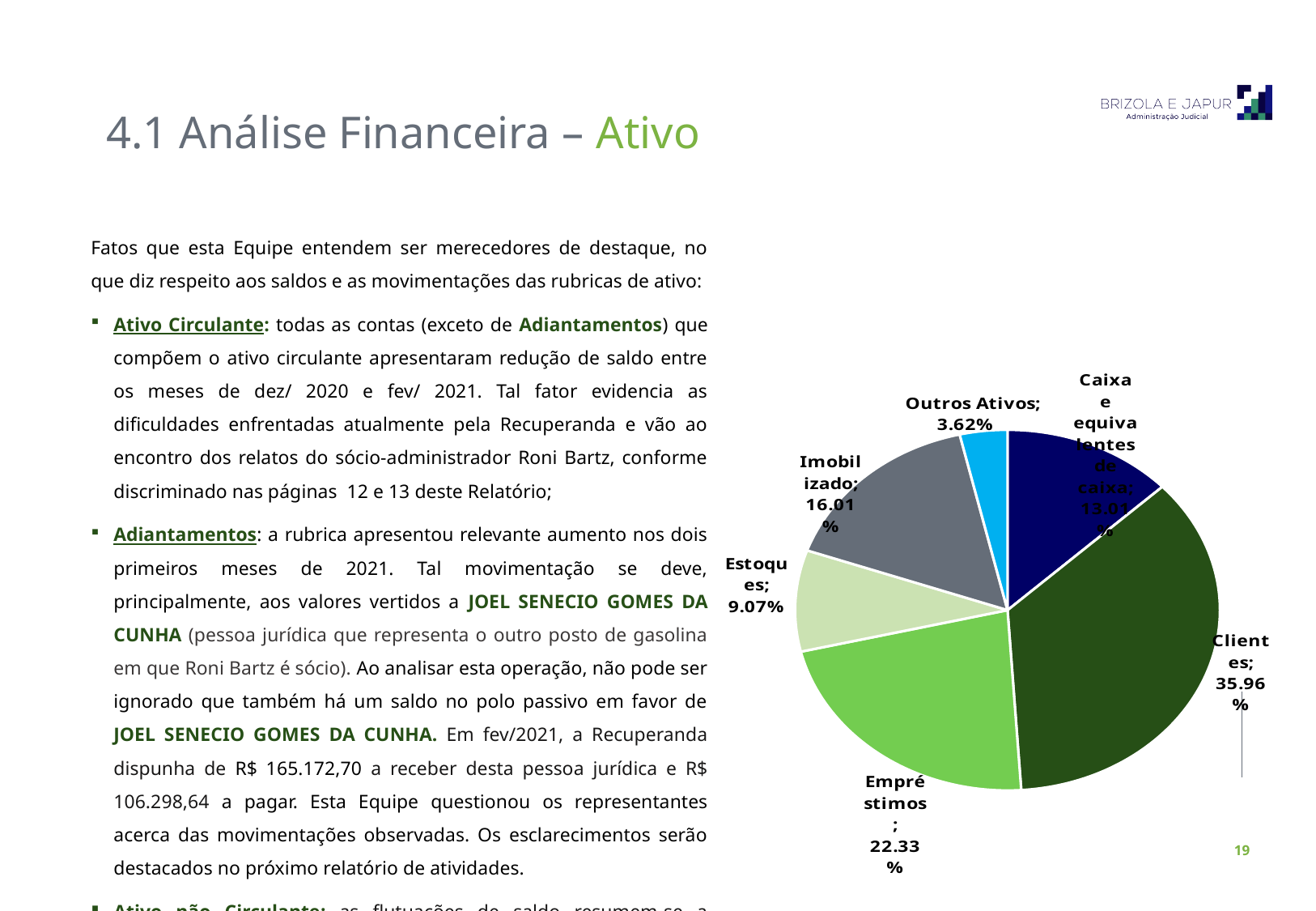
Which is larger in the pie chart, Imobilizado or Estoques? Imobilizado What is the share for Estoques in the pie chart? 9.07% What is the share for Clientes in the pie chart? 35.96% Which slice of the pie chart is the smallest? Outros Ativos How many slices does the pie chart have? 6 What is the share for Outros Ativos in the pie chart? 3.62% What is the share for Imobilizado in the pie chart? 16.01% What is the share for Empréstimos in the pie chart? 22.33% What is the share for Caixa e equivalentes de caixa in the pie chart? 13.01% What is the difference in percentage points between Clientes and Empréstimos in the pie chart? 13.63 Which slice of the pie chart is the largest? Clientes What kind of chart is shown on the slide? pie chart